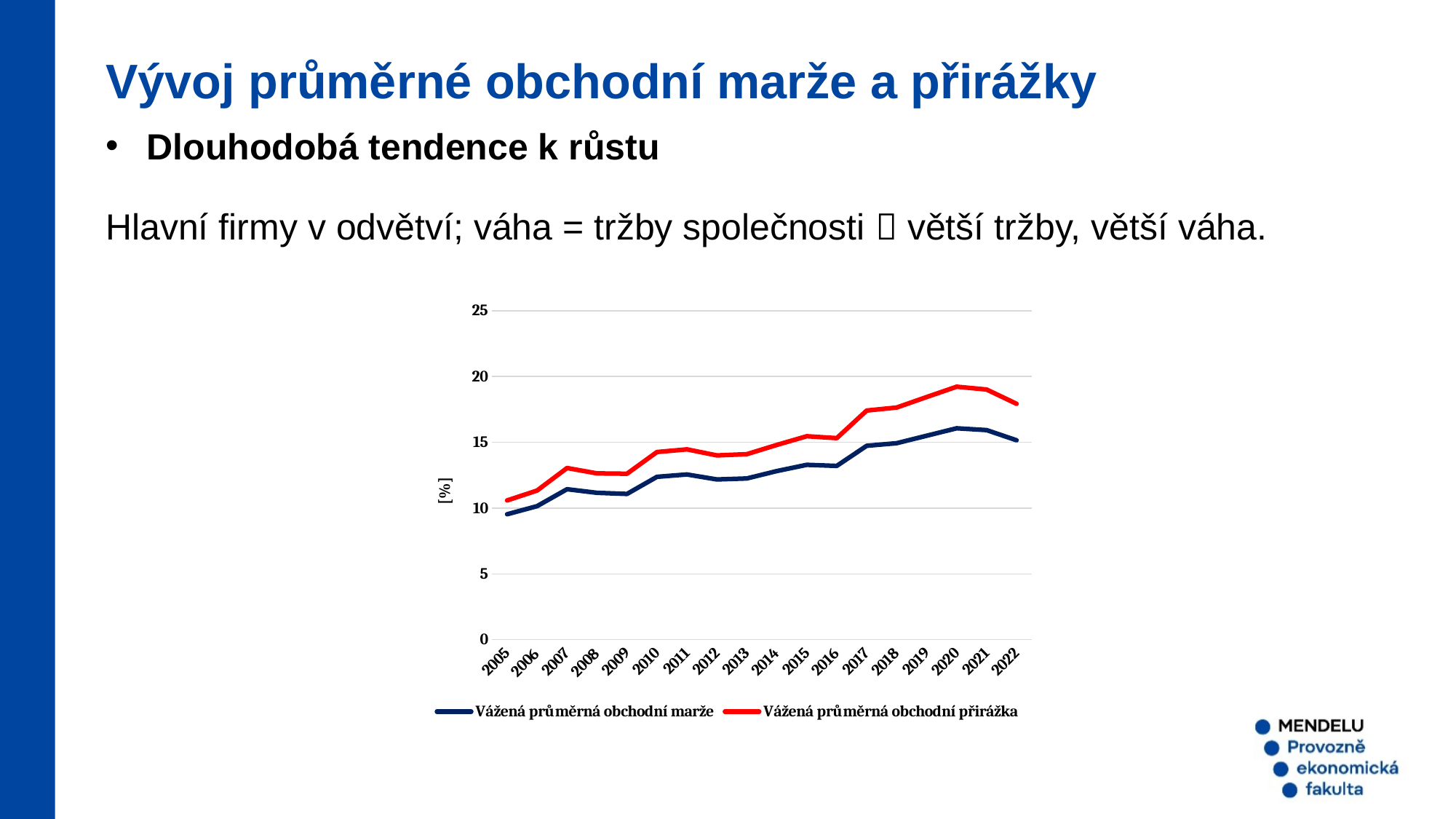
Is the value for Vážená průměrná obchodní přirážka in 2020 greater or less than 20? less Is the value for Vážená průměrná obchodní marže in 2020 greater or less than 15? greater In which year is Vážená průměrná obchodní marže lowest? 2005 How many years are shown on the x axis? 18 How many series does the legend list? 2 In 2022, which series has the higher value, Vážená průměrná obchodní marže or Vážená průměrná obchodní přirážka? Vážená průměrná obchodní přirážka What unit is shown on the y axis label? [%] Is the value for Vážená průměrná obchodní marže in 2005 greater or less than 10? less What is the first year shown on the x axis? 2005 What kind of chart is shown on the slide? line chart In which year is Vážená průměrná obchodní přirážka highest? 2020